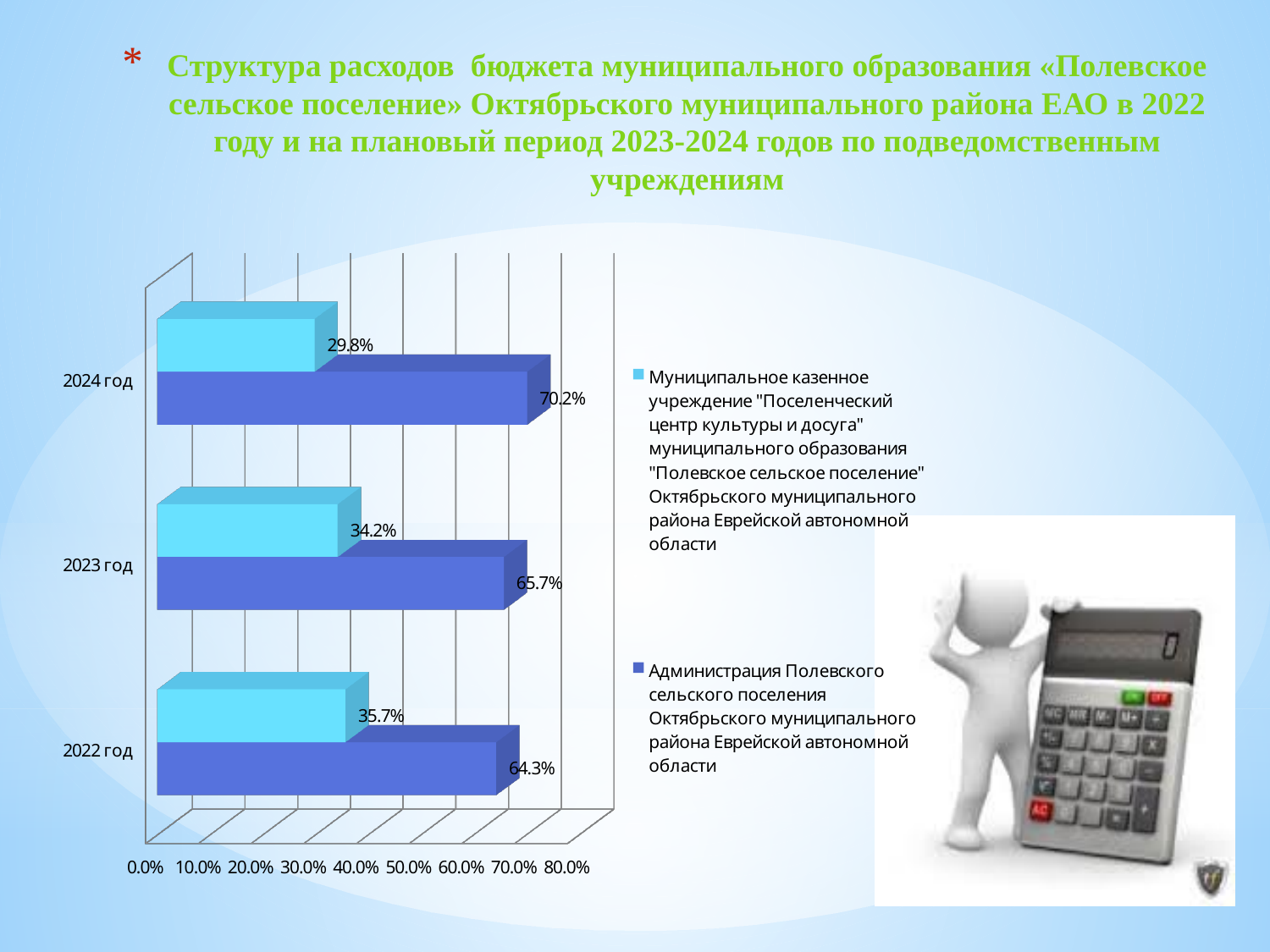
What is the difference between the two series' values in 2022 год? 28.6% What is the value for Администрация Полевского сельского поселения in 2024 год? 70.2% What is the value for Муниципальное казенное учреждение "Поселенческий центр культуры и досуга" in 2024 год? 29.8% In which year is the value for Муниципальное казенное учреждение "Поселенческий центр культуры и досуга" the lowest? 2024 год In which year is the value for Администрация Полевского сельского поселения the highest? 2024 год What is the value for Администрация Полевского сельского поселения in 2023 год? 65.7% How many series does the legend list? 2 How many years are shown on the chart? 3 What kind of chart is shown on the slide? Bar chart Which series has the larger value in 2023 год? Администрация Полевского сельского поселения Which colour represents Администрация Полевского сельского поселения in the chart? Dark blue What is the value for Муниципальное казенное учреждение "Поселенческий центр культуры и досуга" in 2022 год? 35.7%